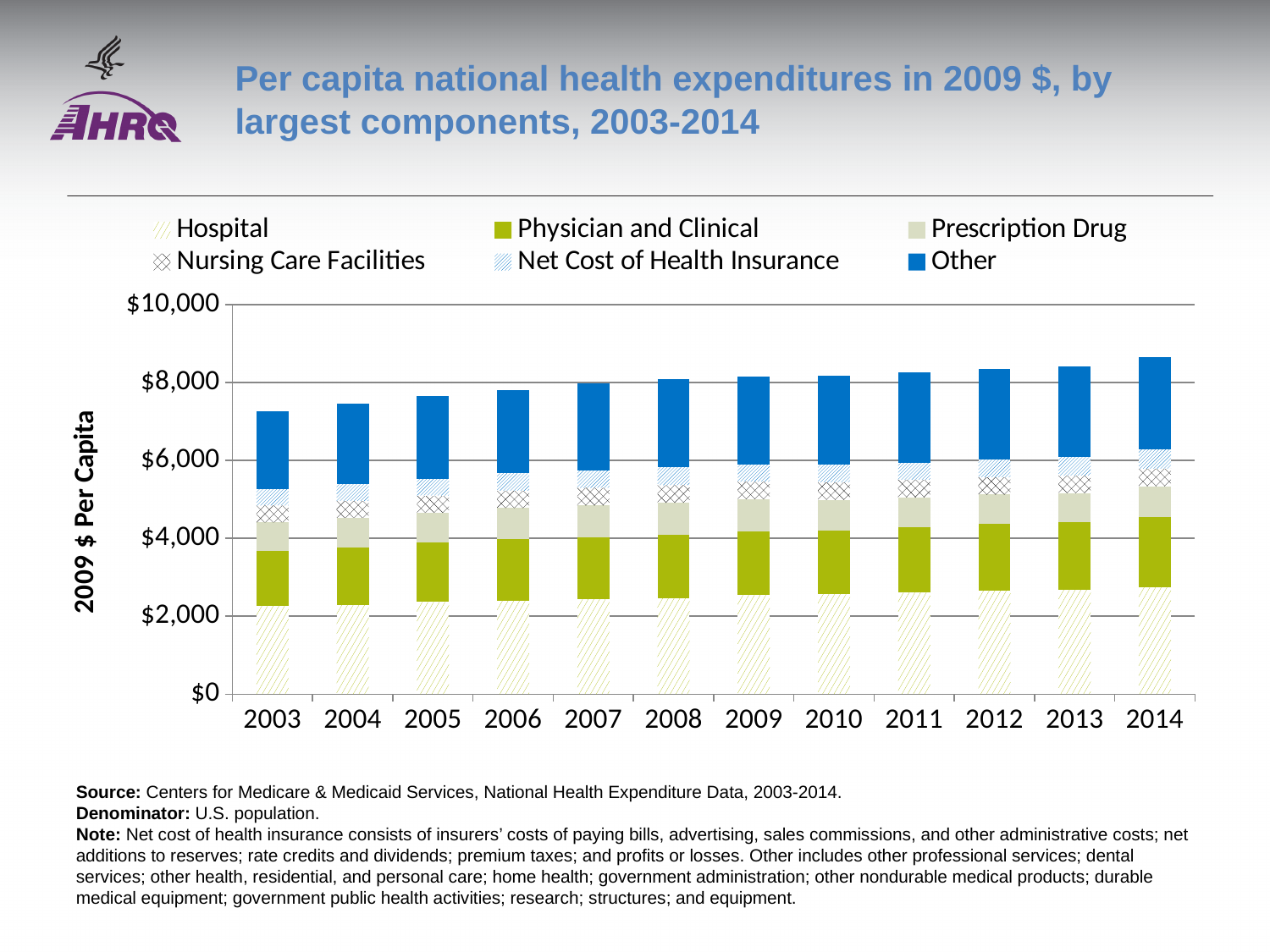
What kind of chart is shown on the slide? Stacked bar chart Is the total per capita expenditure for 2003 greater or less than $8,000? less Is the total per capita expenditure for 2005 greater or less than $8,000? less Which year has the highest total per capita expenditure bar? 2014 How many years are shown along the x axis of the chart? 12 What is the label on the chart's vertical axis? 2009 $ Per Capita How many series does the chart's legend list? 6 Is the total per capita expenditure for 2014 greater or less than $8,000? greater Which year has the larger total bar, 2003 or 2014? 2014 Do the total per capita expenditures rise or fall from 2003 to 2014? rise Which year has the lowest total per capita expenditure bar? 2003